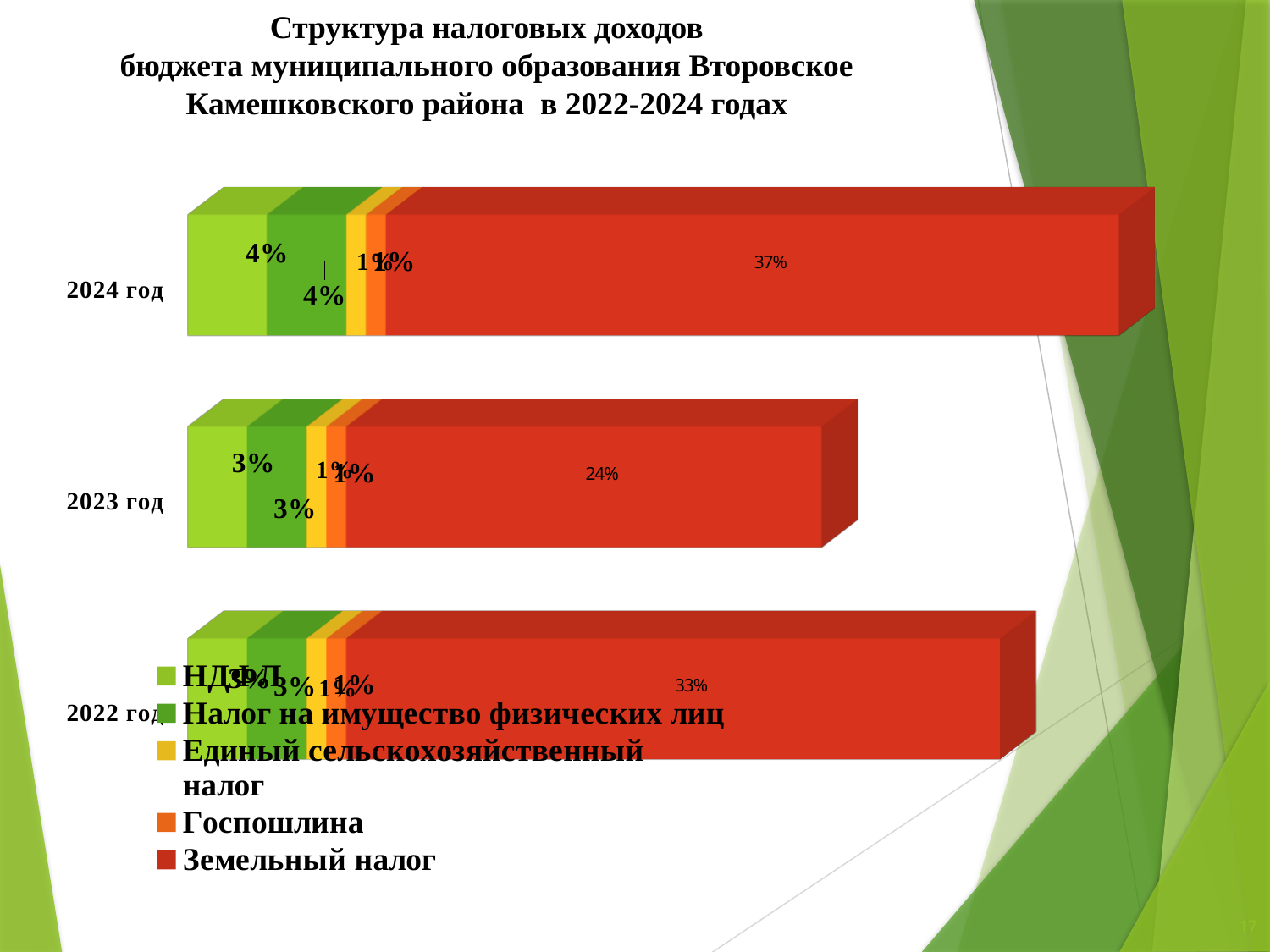
What is the value for НДФЛ in 2024 год? 4% What is the value for Земельный налог in 2024 год? 37% What is the value for Земельный налог in 2023 год? 24% What is the value for Налог на имущество физических лиц in 2023 год? 3% How many series does the legend list? 5 In which year is the value for Земельный налог the highest? 2024 год What is the total of the stacked bar for 2024 год? 47% What kind of chart is shown on the slide? Stacked bar chart What is the difference between the Земельный налог values for 2024 год and 2023 год? 13 percentage points How many years (categories) are plotted on the chart? 3 What is the value for Земельный налог in 2022 год? 33% In which year is the value for Земельный налог the lowest? 2023 год